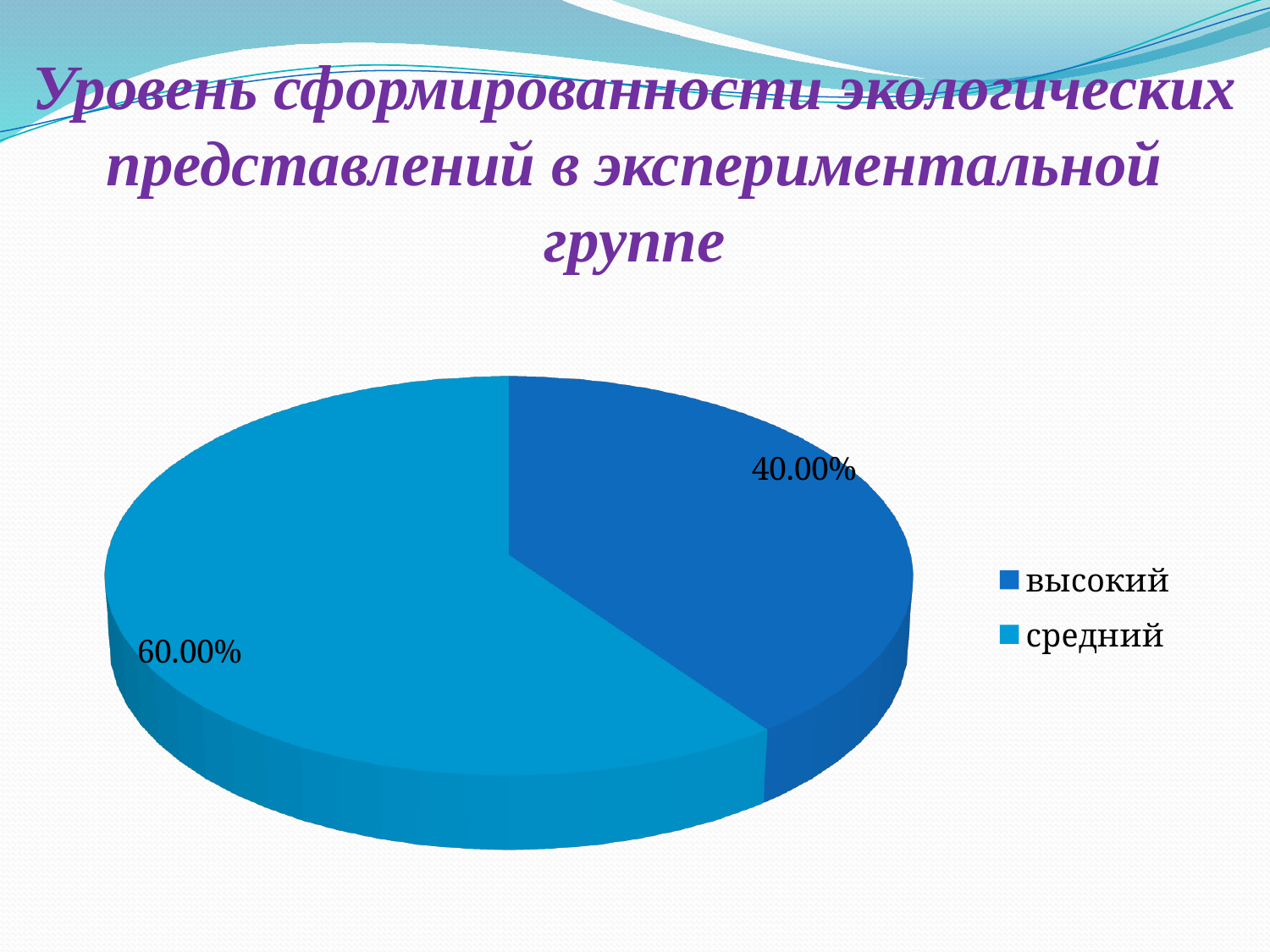
What is the difference in percentage points between the "средний" and "высокий" slices? 20.00% What kind of chart is shown on the slide? pie chart Which category has the smallest slice of the pie? высокий Which legend entry is shown in the lighter blue colour? средний What share of the pie does the "высокий" slice represent? 40.00% Which category has the largest slice of the pie? средний What share of the pie does the "средний" slice represent? 60.00% Which slice is larger, "высокий" or "средний"? средний How many slices does the pie chart have? 2 How many entries does the legend list? 2 What is the title of the slide containing the chart? Уровень сформированности экологических представлений в экспериментальной группе